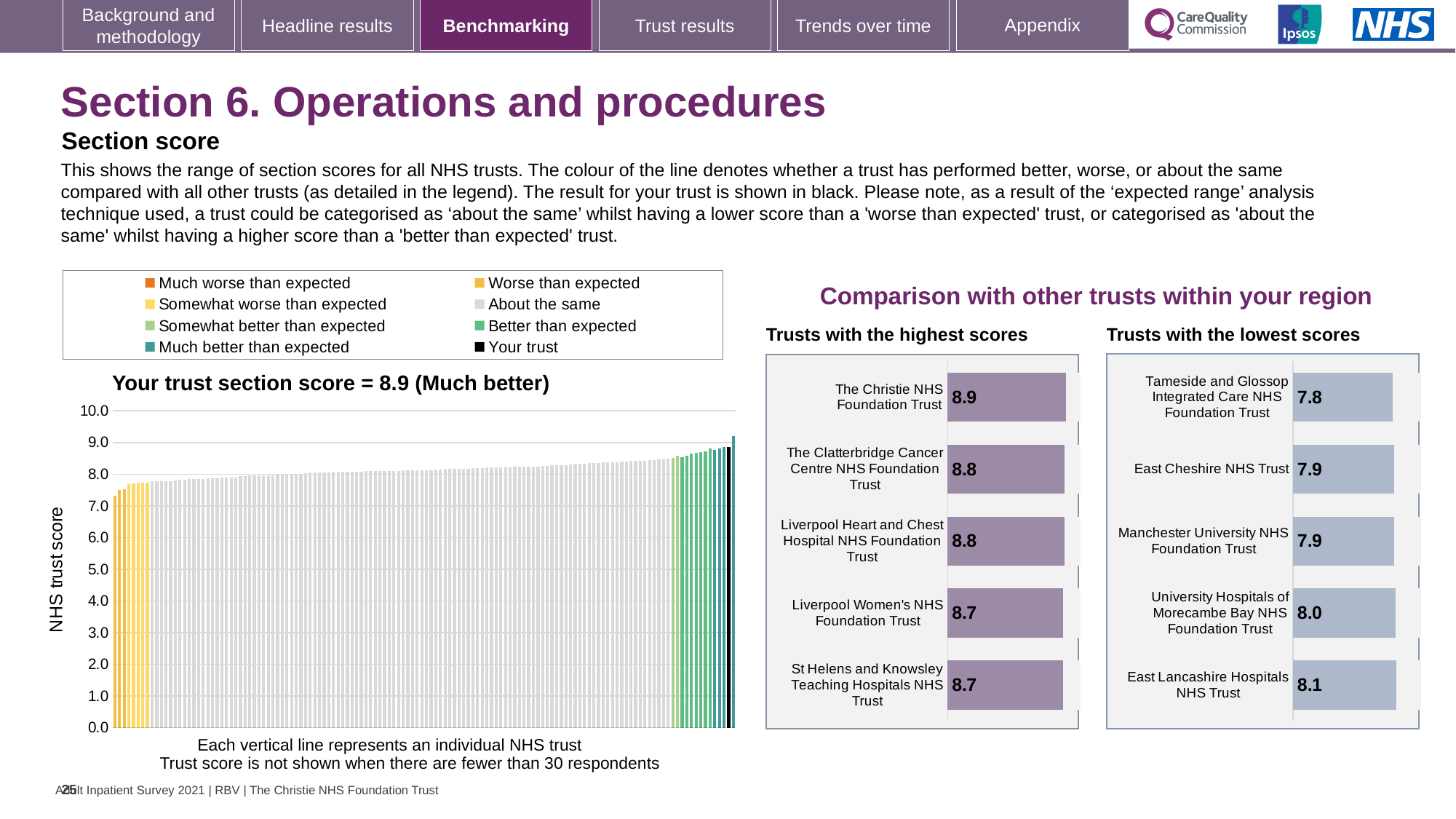
In the 'Trusts with the lowest scores' chart, which has the larger score: East Cheshire NHS Trust or University Hospitals of Morecambe Bay NHS Foundation Trust? University Hospitals of Morecambe Bay NHS Foundation Trust In the 'Trusts with the lowest scores' chart, what is the difference between the scores of East Lancashire Hospitals NHS Trust and Tameside and Glossop Integrated Care NHS Foundation Trust? 0.3 In the 'Trusts with the lowest scores' chart, what is the score for Tameside and Glossop Integrated Care NHS Foundation Trust? 7.8 How many entries does the legend above the 'Your trust section score' chart list? 8 In the 'Trusts with the highest scores' chart, what is the score for The Christie NHS Foundation Trust? 8.9 In the 'Your trust section score' chart on the left, do the trust scores rise or fall from left to right? Rise In the 'Trusts with the highest scores' chart, which trust has the highest score? The Christie NHS Foundation Trust How many trusts are shown in the 'Trusts with the highest scores' chart? 5 In the 'Trusts with the highest scores' chart, what is the difference between the scores of The Christie NHS Foundation Trust and St Helens and Knowsley Teaching Hospitals NHS Trust? 0.2 What kind of chart is the 'Your trust section score' chart on the left of the slide? Bar chart In the 'Trusts with the lowest scores' chart, which trust has the lowest score? Tameside and Glossop Integrated Care NHS Foundation Trust In the 'Trusts with the lowest scores' chart, which trust has the highest score? East Lancashire Hospitals NHS Trust